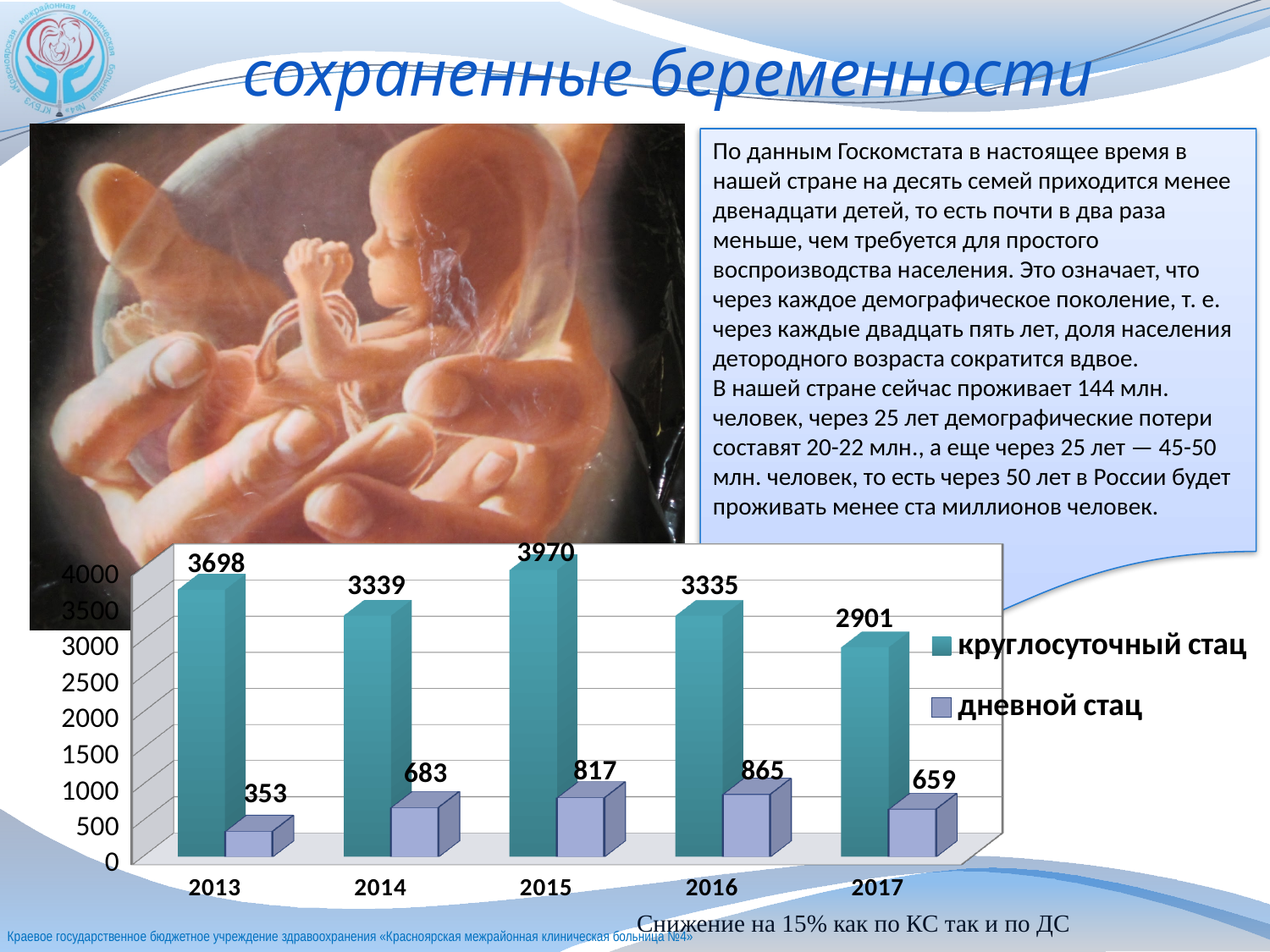
In which year is the value for дневной стац the lowest? 2013 In which year is the value for круглосуточный стац the highest? 2015 What is the value for круглосуточный стац in 2015? 3970 Which series is shown in teal in the chart legend? круглосуточный стац What kind of chart is shown on the slide? bar chart How many years are shown on the x axis of the chart? 5 What is the value for дневной стац in 2013? 353 What is the difference between the круглосуточный стац values for 2013 and 2017? 797 What is the value for круглосуточный стац in 2017? 2901 Which is larger: the дневной стац value for 2014 or for 2016? 2016 How many series does the chart legend list? 2 Does the value for круглосуточный стац rise or fall from 2015 to 2017? fall